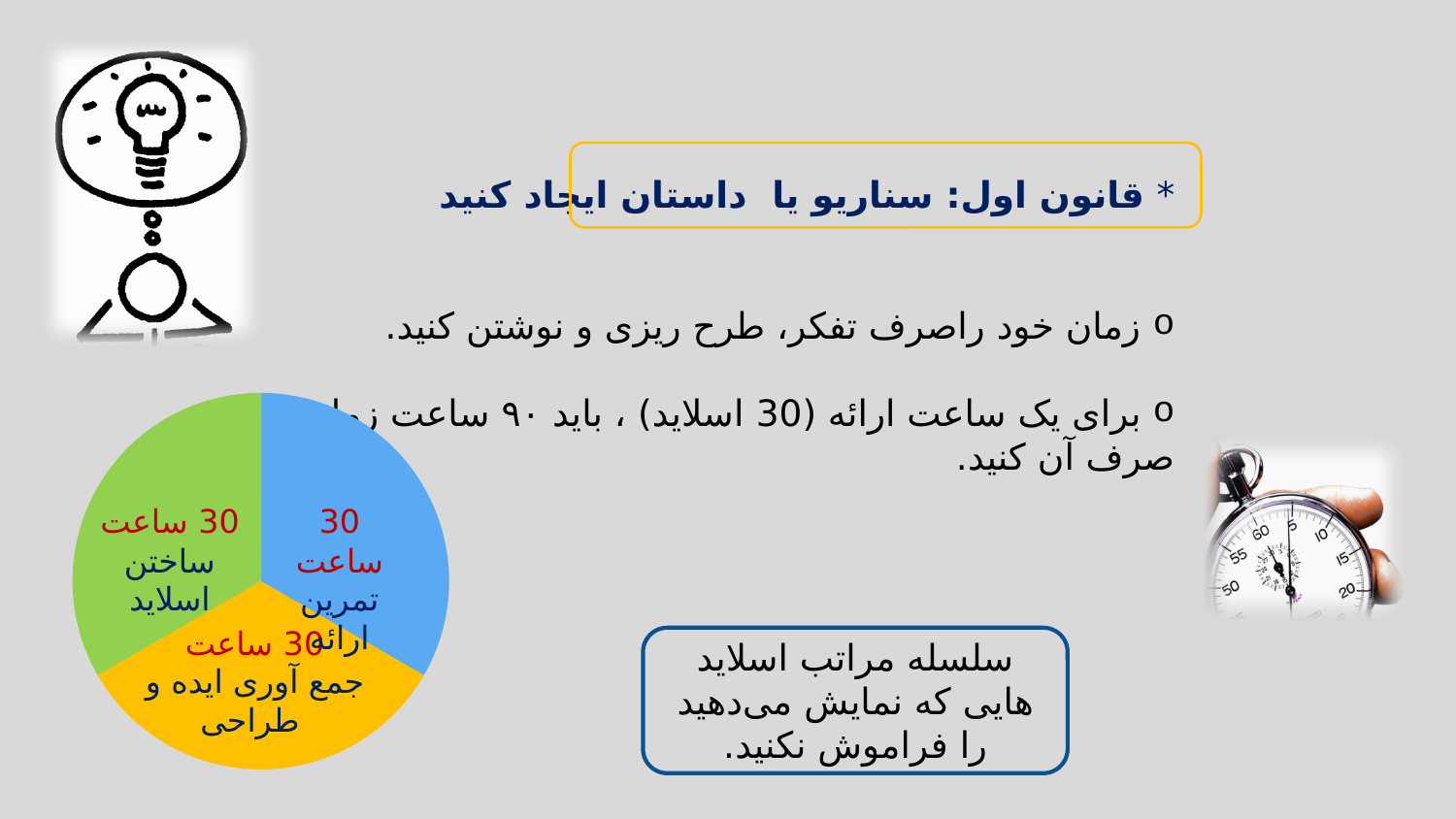
What is the difference in hours between the slice for practicing the presentation and the slice for building the slides? 0 How many hours does the pie chart assign to gathering ideas and design (جمع آوری ایده و طراحی)? 30 ساعت What is the total number of hours across all three slices of the pie chart? 90 ساعت What share of the pie does the slice for practicing the presentation (تمرین ارائه) represent? one third How many slices does the pie chart have? 3 Which colour is the slice for gathering ideas and design (جمع آوری ایده و طراحی) in the pie chart? yellow How many hours does the pie chart assign to practicing the presentation (تمرین ارائه)? 30 ساعت What share of the pie does the slice for building the slides (ساختن اسلاید) represent? one third What kind of chart is shown on the slide? pie chart Which colour is the slice for building the slides (ساختن اسلاید) in the pie chart? green How many hours does the pie chart assign to building the slides (ساختن اسلاید)? 30 ساعت